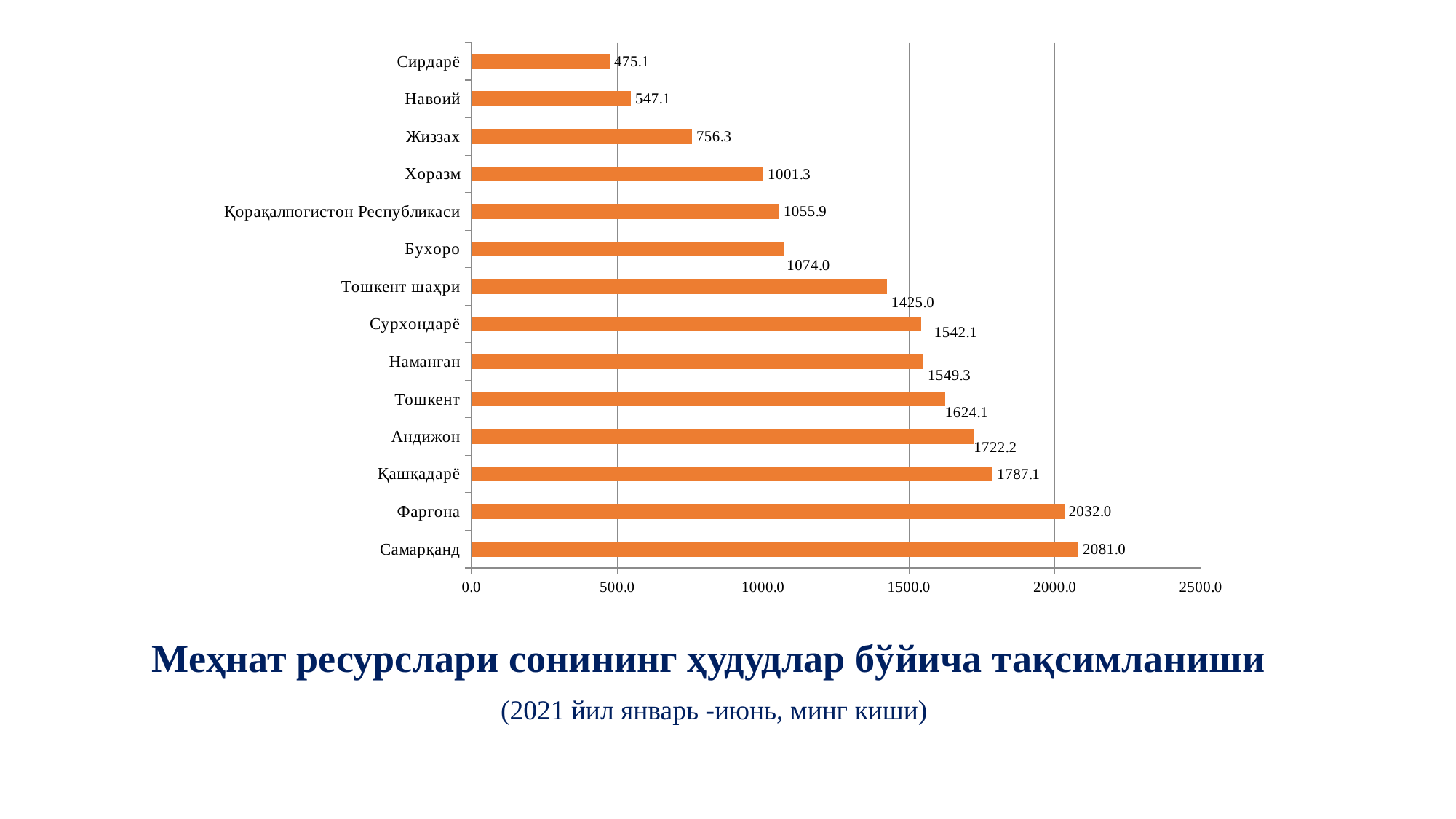
What is the difference between the values for Навоий and Сирдарё? 72.0 What is the value for Тошкент шаҳри? 1425.0 Which has a larger value, Андижон or Тошкент? Андижон What is the title of the chart? Меҳнат ресурслари сонининг ҳудудлар бўйича тақсимланиши Which region has the lowest value? Сирдарё Which region has the highest value? Самарқанд What kind of chart is shown on the slide? bar chart What is the difference between the values for Самарқанд and Фарғона? 49.0 What is the value for Қорақалпоғистон Республикаси? 1055.9 How many regions are shown in the chart? 14 What is the value for Самарқанд? 2081.0 Is the value for Жиззах greater or less than 1000? less